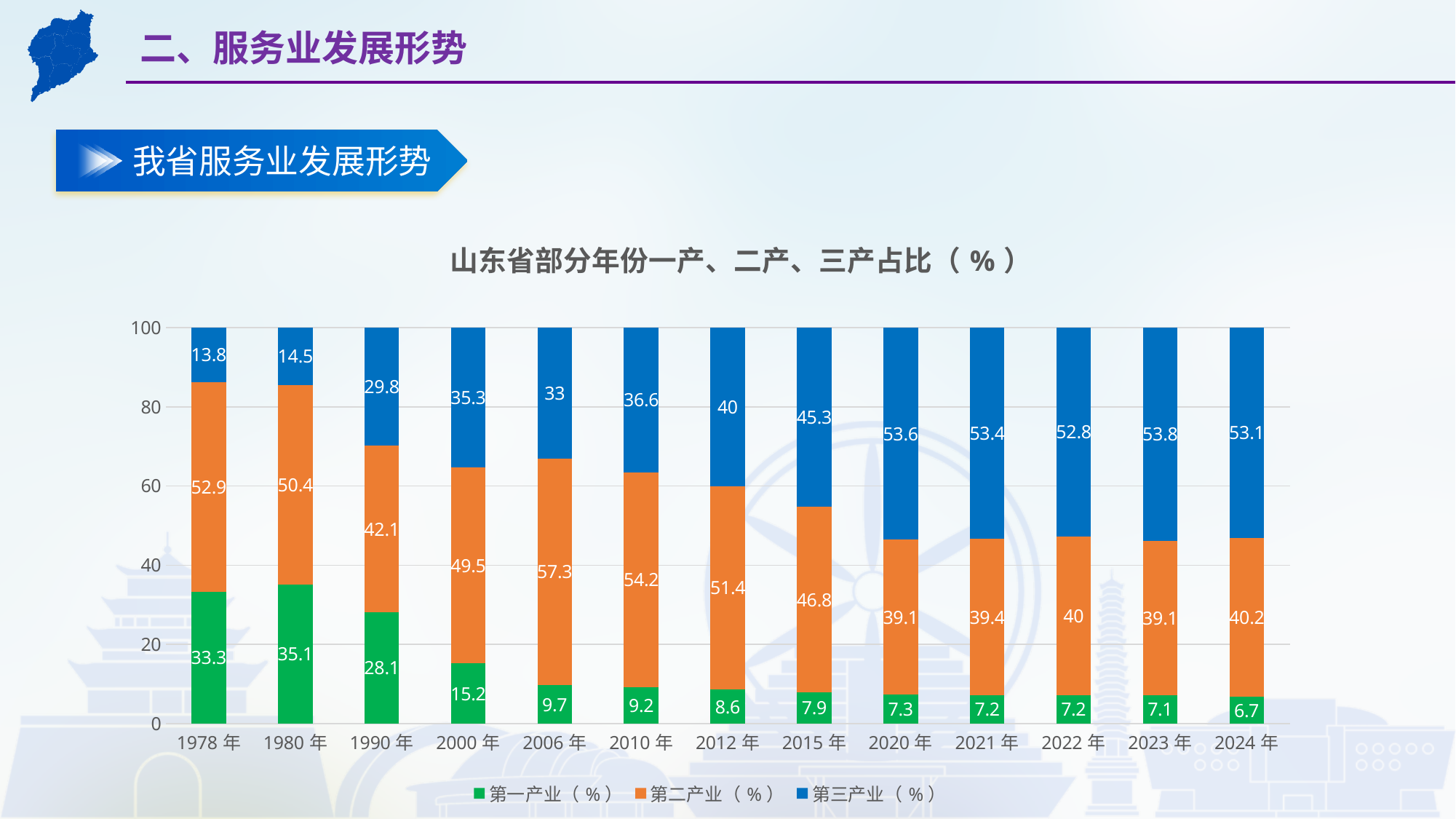
What is the title of the chart? 山东省部分年份一产、二产、三产占比（%） Which year has the highest value for 第一产业（%）? 1980 年 How many series does the legend list? 3 Which year has the lowest value for 第三产业（%）? 1978 年 How many years are shown on the x axis? 13 What kind of chart is shown on the slide? Stacked bar chart Does the value of 第一产业（%） rise or fall from 1980 年 to 2024 年? Fall What is the value of 第三产业（%） for 2024 年? 53.1 Which is larger in 2015 年: 第二产业（%） or 第三产业（%）? 第二产业（%） What is the value of 第一产业（%） for 1978 年? 33.3 What is the difference between the 第三产业（%） values for 2020 年 and 1978 年? 39.8 What is the value of 第二产业（%） for 2006 年? 57.3